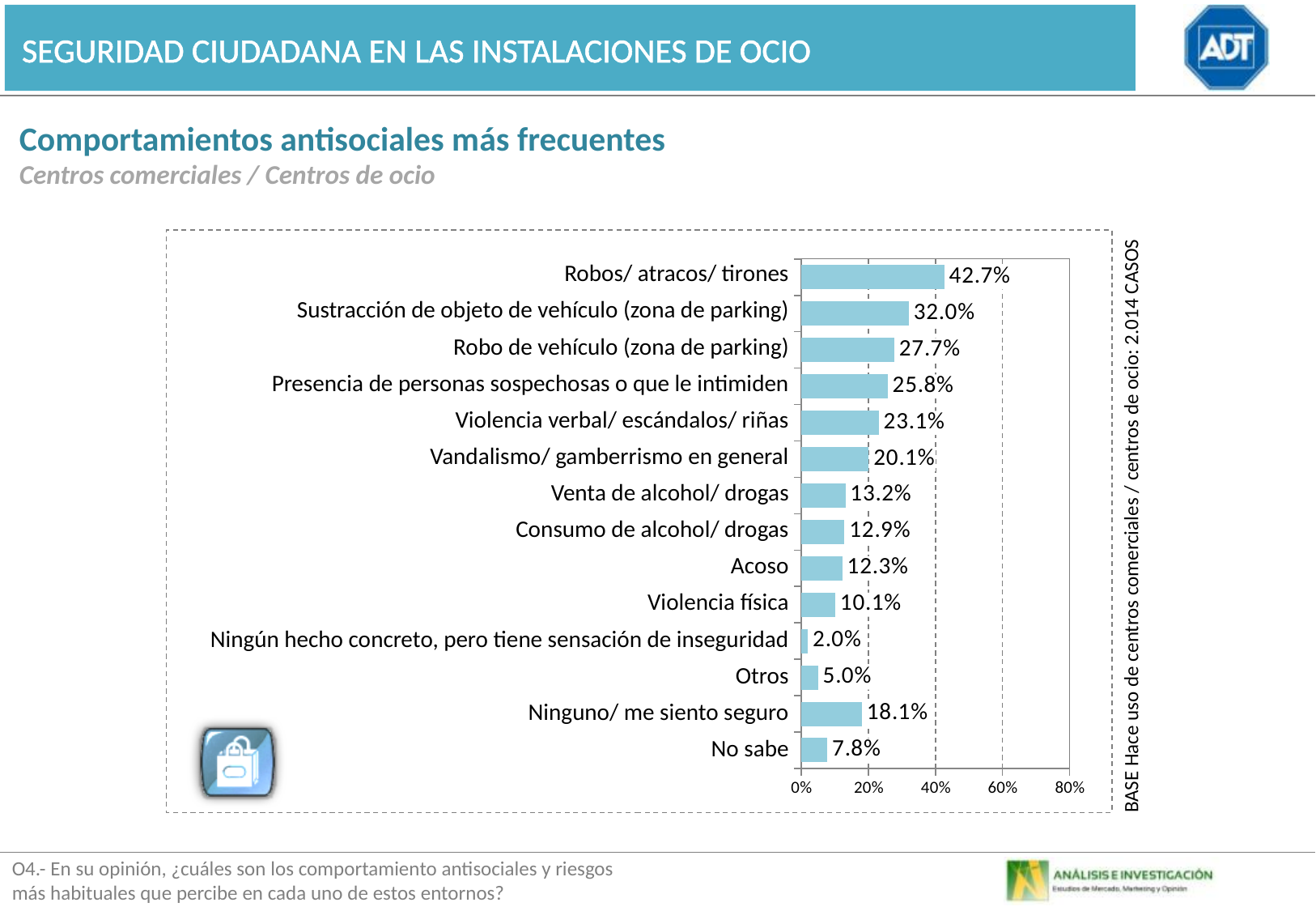
What is the difference between "Robos/ atracos/ tirones" and "Sustracción de objeto de vehículo (zona de parking)"? 10.7% What is the value for "Vandalismo/ gamberrismo en general"? 20.1% What is the title of the chart on the slide? Comportamientos antisociales más frecuentes Is the value for "Robo de vehículo (zona de parking)" greater or less than 20%? greater What kind of chart is shown on the slide? bar chart Which category has the highest value? Robos/ atracos/ tirones Which category has the lowest value? Ningún hecho concreto, pero tiene sensación de inseguridad What is the value for "Ninguno/ me siento seguro"? 18.1% What is the value for "No sabe"? 7.8% How many categories are shown in the chart? 14 What is the value for "Robos/ atracos/ tirones"? 42.7% Which is larger: "Venta de alcohol/ drogas" or "Violencia física"? Venta de alcohol/ drogas